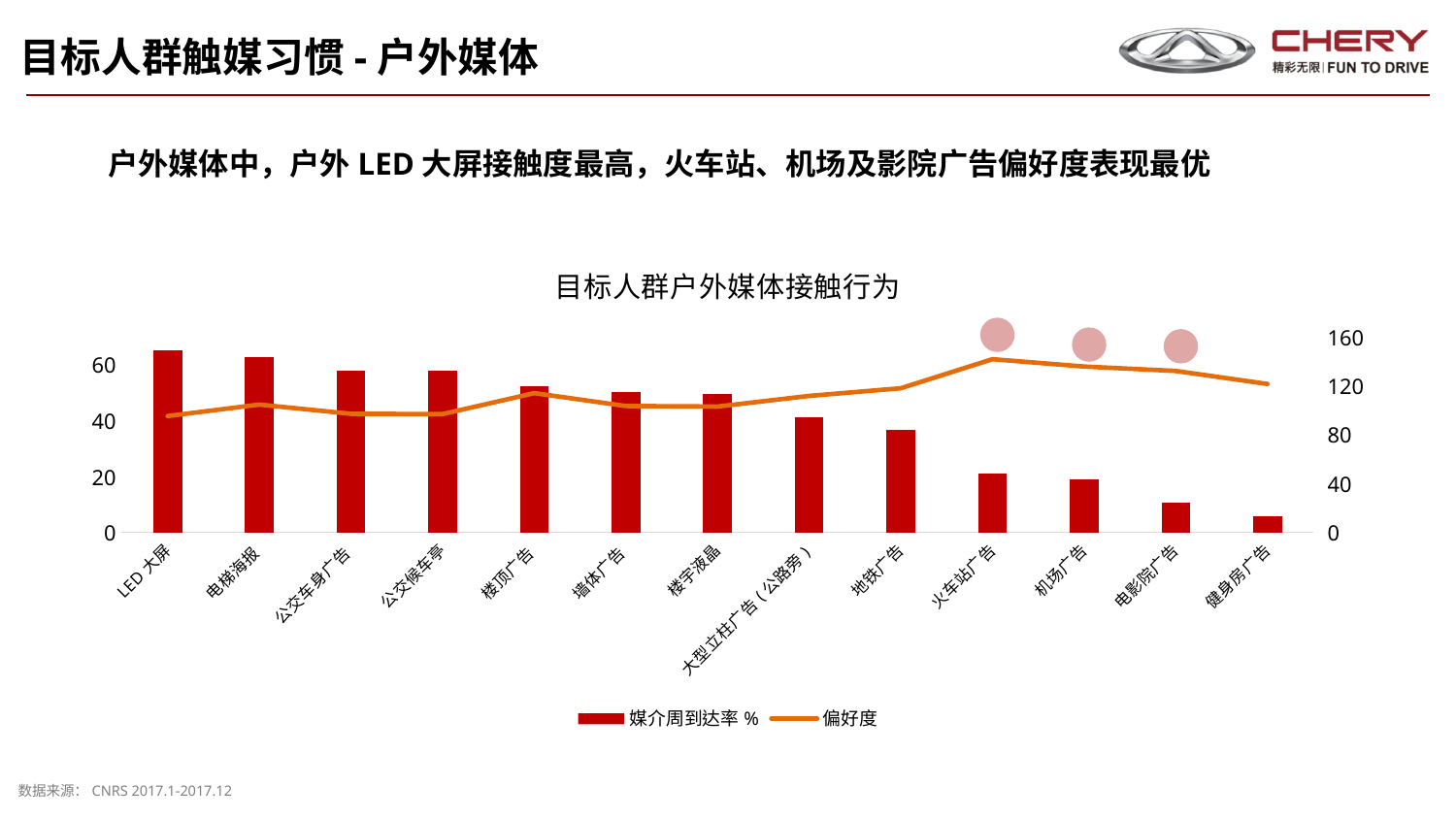
Which has a larger 媒介周到达率 % bar, 电梯海报 or 地铁广告? 电梯海报 Is the 偏好度 value for 火车站广告 greater or less than 120? greater Is the 媒介周到达率 % value for LED 大屏 greater or less than 60? greater How many outdoor media categories are shown on the x axis of the chart? 13 Is the 媒介周到达率 % value for 电影院广告 greater or less than 20? less Which category has the highest 偏好度 value on the line? 火车站广告 Which category has the highest 媒介周到达率 % bar? LED 大屏 What kind of chart is shown on the slide? A combined bar and line chart Do the 媒介周到达率 % bars generally rise or fall from left to right along the x axis? fall How many series does the chart legend list? 2 Which category has the lowest 媒介周到达率 % bar? 健身房广告 What is the title of the chart? 目标人群户外媒体接触行为